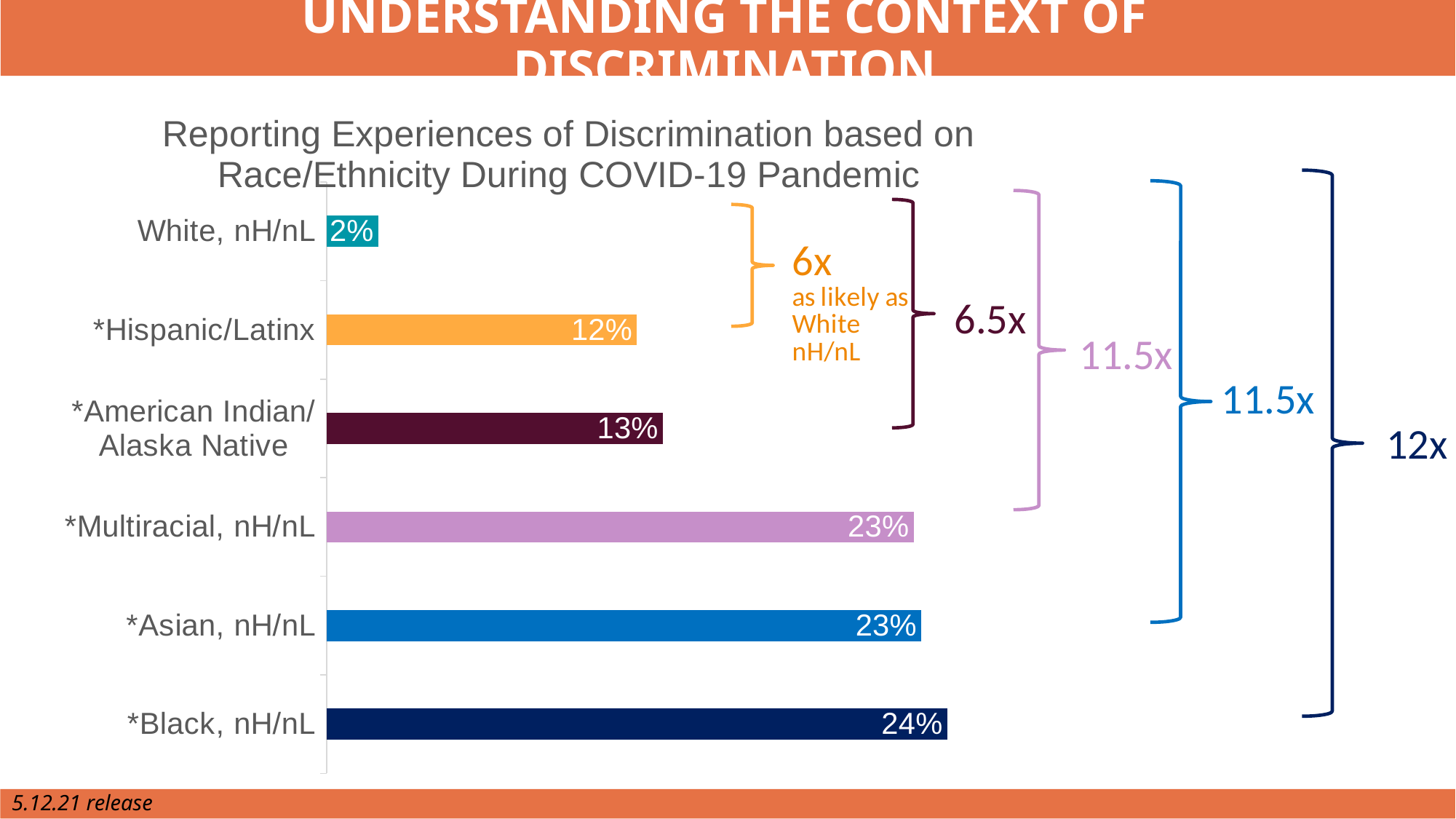
Which is larger, the value for *Hispanic/Latinx or the value for *Multiracial, nH/nL? *Multiracial, nH/nL Which group has the lowest percentage reporting discrimination? White, nH/nL What percentage is shown for *American Indian/Alaska Native? 13% According to the annotation, how many times as likely as White, nH/nL are *Hispanic/Latinx respondents to report discrimination? 6x How many race/ethnicity groups are shown in the chart? 6 What is the value for *Black, nH/nL? 24% Which group has the highest percentage reporting discrimination? *Black, nH/nL What type of chart is used on this slide? Bar chart What is the value shown for *Hispanic/Latinx? 12% What percentage of White, nH/nL respondents reported experiences of discrimination? 2% What is the difference in percentage points between *Black, nH/nL and White, nH/nL? 22 percentage points What multiplier does the annotation give for *Black, nH/nL compared with White, nH/nL? 12x